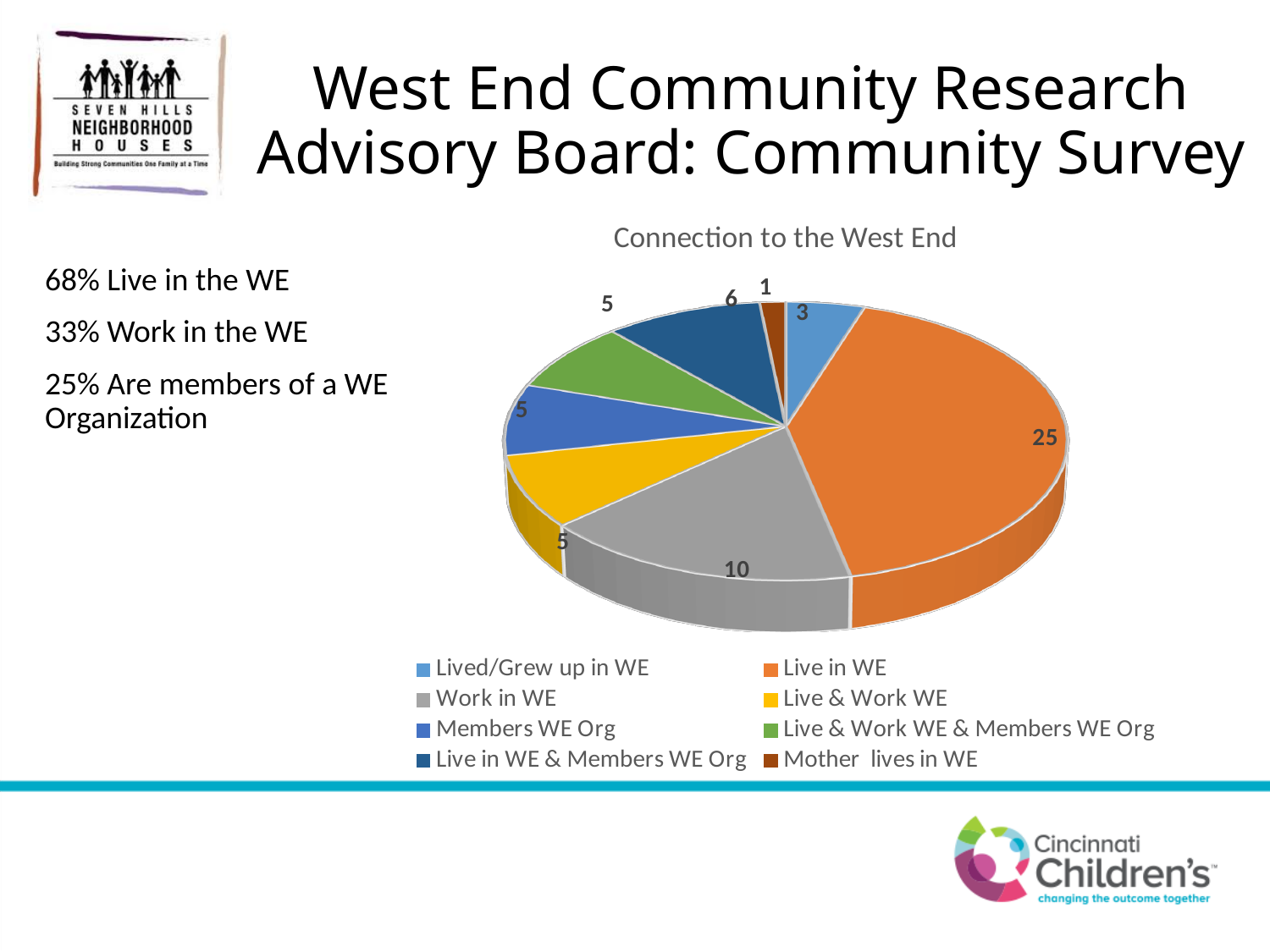
What is the value for "Live in WE & Members WE Org"? 6 What is the title of the chart? Connection to the West End What is the difference between the values for "Live in WE" and "Work in WE"? 15 What kind of chart is shown on the slide? Pie chart Which is larger, "Lived/Grew up in WE" or "Live in WE & Members WE Org"? Live in WE & Members WE Org Which category has the largest slice? Live in WE What is the value for "Live in WE"? 25 What is the value for "Mother lives in WE"? 1 How many categories does the pie chart have? 8 Which category has the smallest slice? Mother lives in WE What is the value for "Work in WE"? 10 What share of the pie does "Live in WE & Members WE Org" represent? 10%